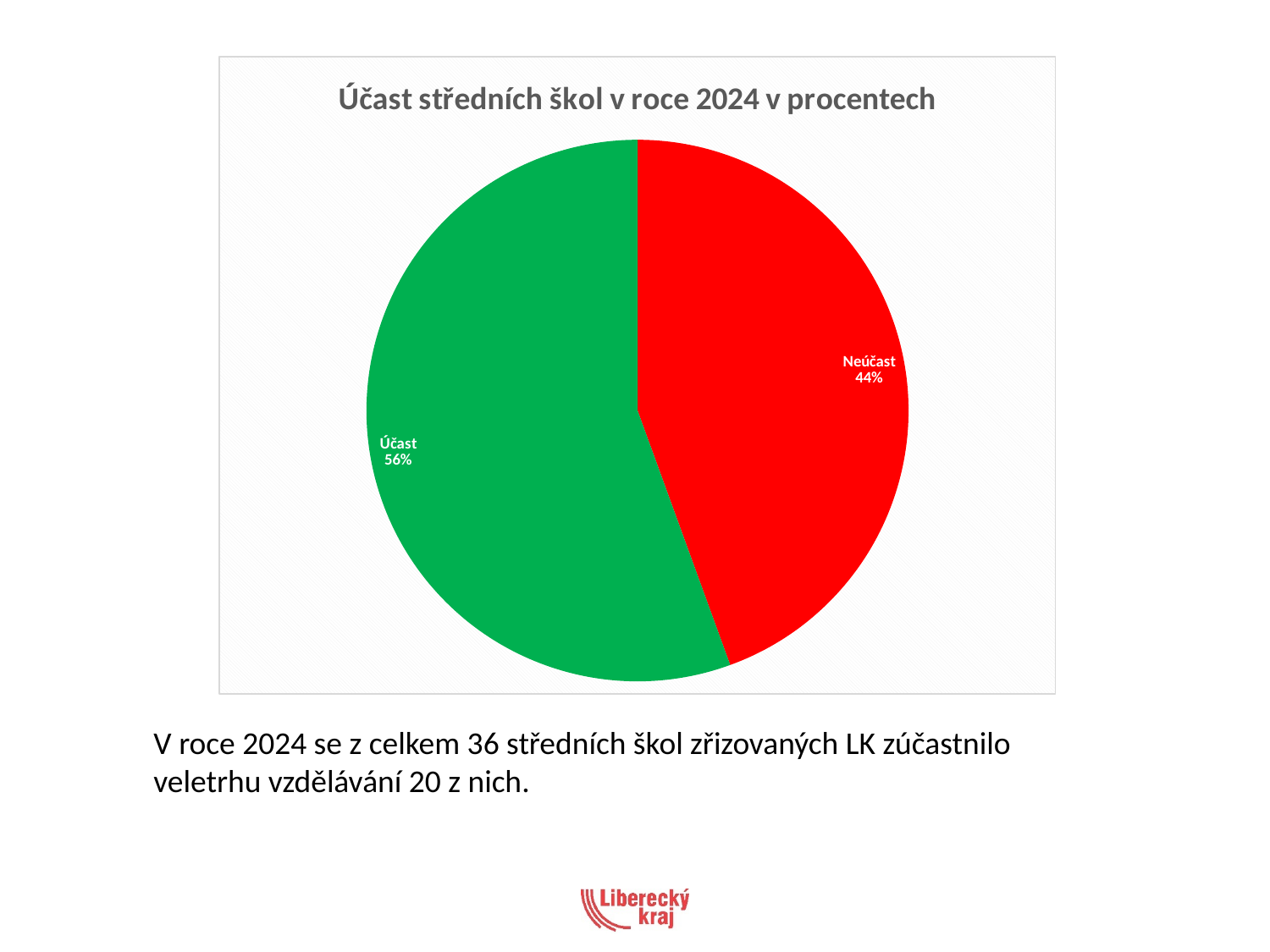
Which is larger, the Účast slice or the Neúčast slice? Účast Which slice is the largest in the pie chart? Účast How many slices does the pie chart have? 2 What is the title of the chart? Účast středních škol v roce 2024 v procentech What colour is the Účast slice? Green What share of the pie does the Účast slice represent? 56% What is the difference in percentage points between the Účast and Neúčast slices? 12 What kind of chart is shown on the slide? Pie chart What share of the pie does the Neúčast slice represent? 44% Is the value for Neúčast greater or less than 50%? less Which slice is the smallest in the pie chart? Neúčast